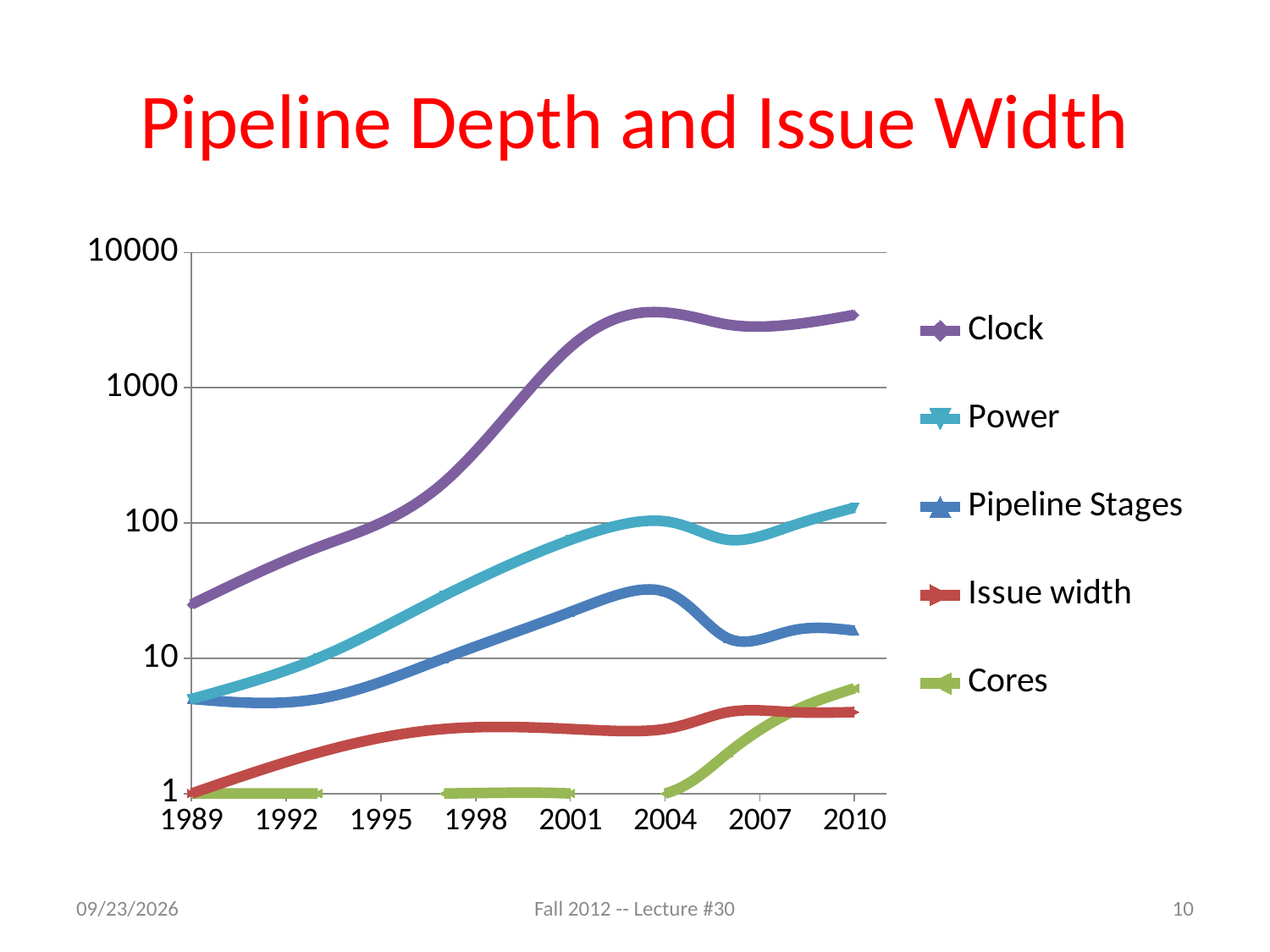
Is the value for Power in 2010 greater or less than 100? greater Which series has the highest value in 2010? Clock What kind of chart is shown on the slide? line chart How many series does the legend list? 5 Is the value for Clock in 2010 greater or less than 1000? greater Is the value for Pipeline Stages in 2010 greater or less than 10? greater Which is larger in 2001, Pipeline Stages or Issue width? Pipeline Stages Which series is plotted with the purple line? Clock Does the Clock series rise or fall from 1989 to 2010? rise Which series has the lowest value in 2004? Cores What is the title of the chart's slide? Pipeline Depth and Issue Width